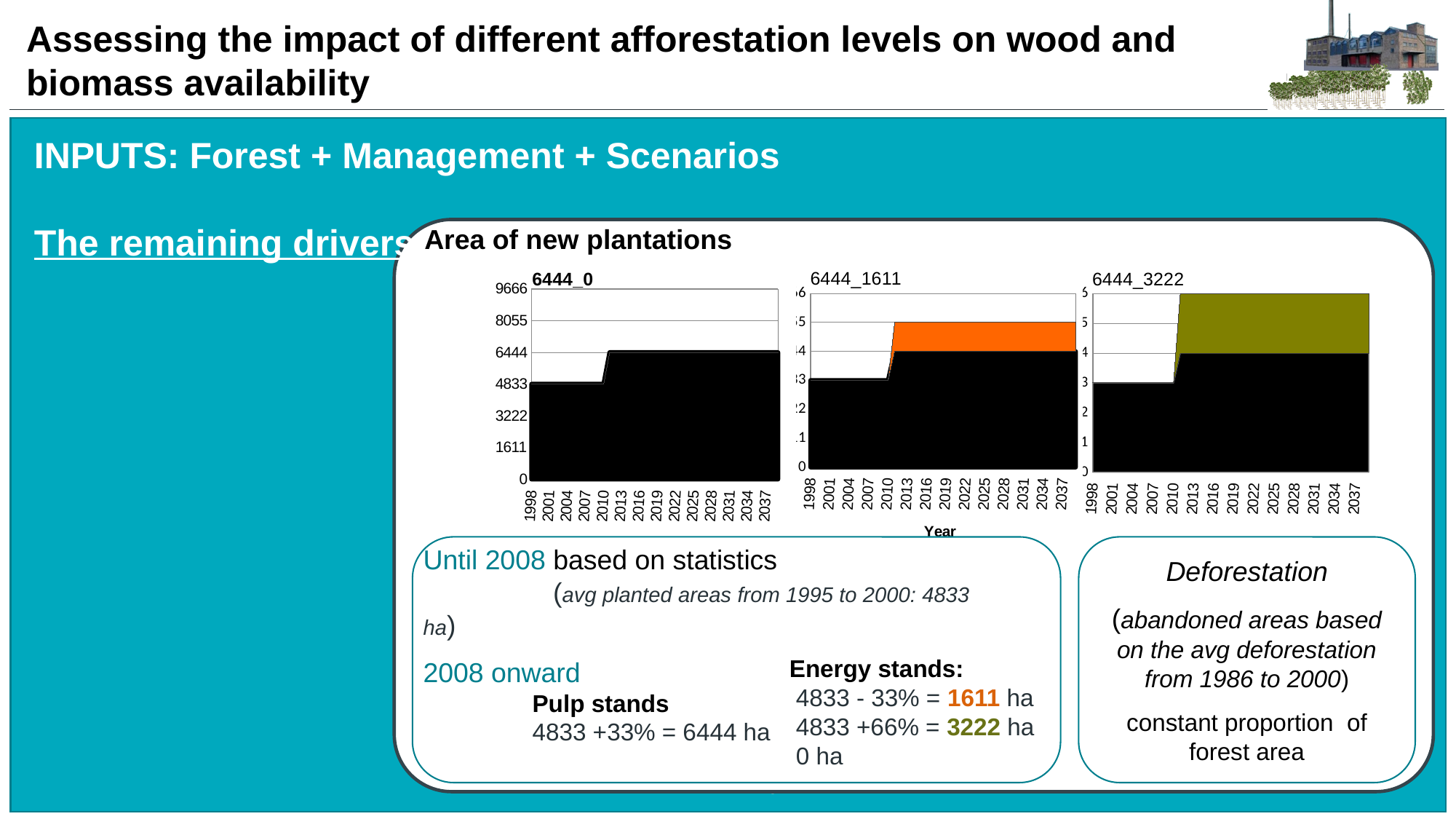
In the "6444_1611" chart, what is the top of the orange area after 2013? 8055 What colour is the upper area in the "6444_1611" chart? orange In the "6444_0" chart, what is the difference between the value in 2037 and the value in 1998? 1611 What kind of chart is the "6444_0" chart? area chart In the "6444_0" chart, is the value in 2004 greater or less than 6444? less In the "6444_3222" chart, what is the top of the olive area after 2013? 9666 In the "6444_0" chart, what is the value of the black area in 1998? 4833 In the "6444_0" chart, what is the value of the black area in 2037? 6444 In the "6444_0" chart, is the value in 2025 greater or less than 4833? greater What is the title printed above the three charts? Area of new plantations How many year labels are shown on the x axis of the "6444_0" chart? 14 In the "6444_0" chart, does the plotted value rise or fall from 1998 to 2037? rise